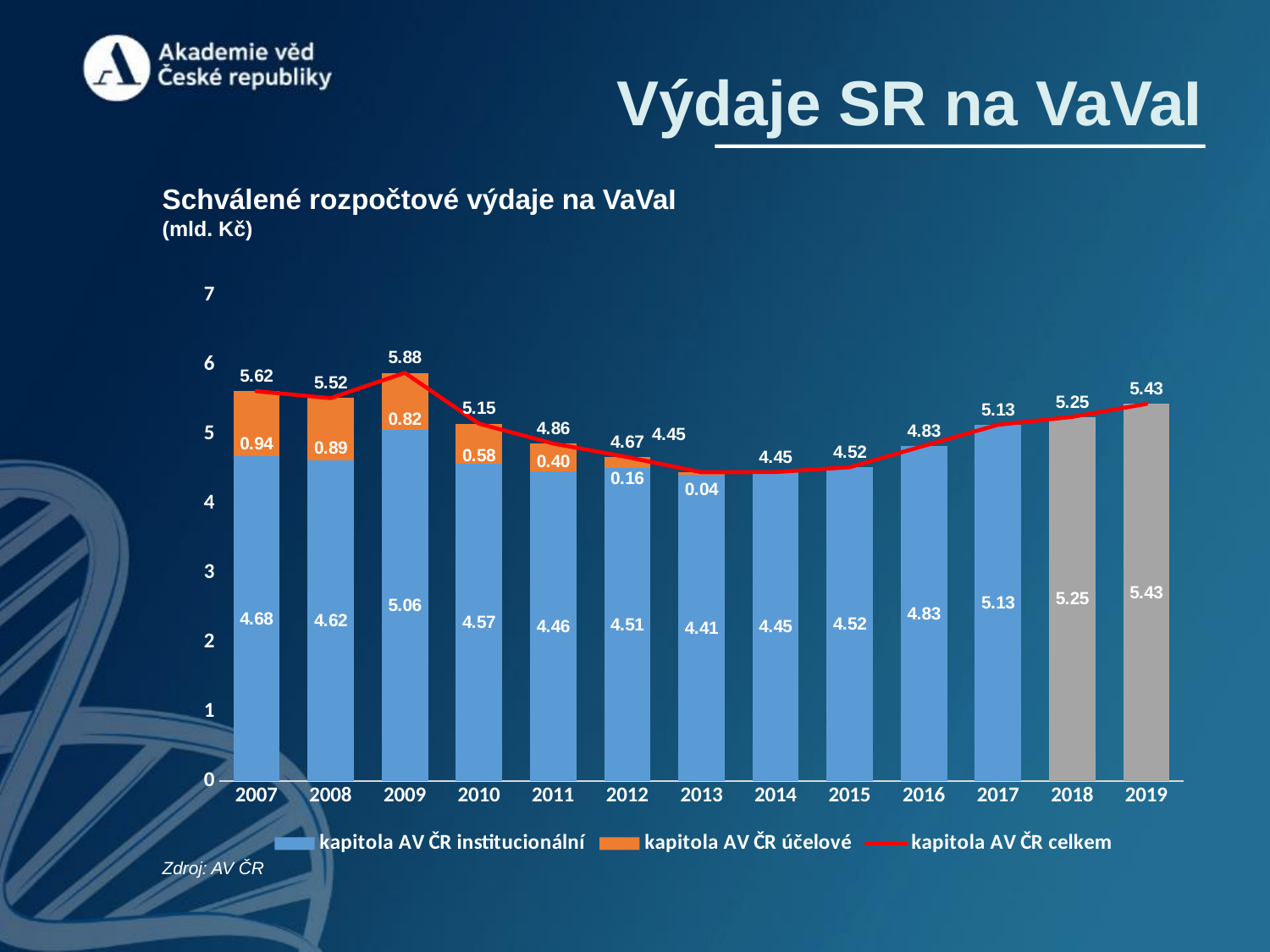
How many series does the legend list? 3 What is the total of the stacked bar for 2007? 5.62 What kind of chart is this? Stacked bar chart with a line What is the value of kapitola AV ČR celkem for 2019? 5.43 Which is larger, kapitola AV ČR institucionální in 2007 or in 2017? 2017 What is the value of kapitola AV ČR institucionální for 2009? 5.06 Does kapitola AV ČR celkem rise or fall from 2013 to 2019? Rise What is the value of kapitola AV ČR účelové for 2010? 0.58 In which year is kapitola AV ČR účelové lowest among the years where it is shown? 2013 In which year is kapitola AV ČR celkem highest? 2009 How many years are shown on the x axis? 13 What is the difference between kapitola AV ČR celkem in 2009 and in 2013? 1.43